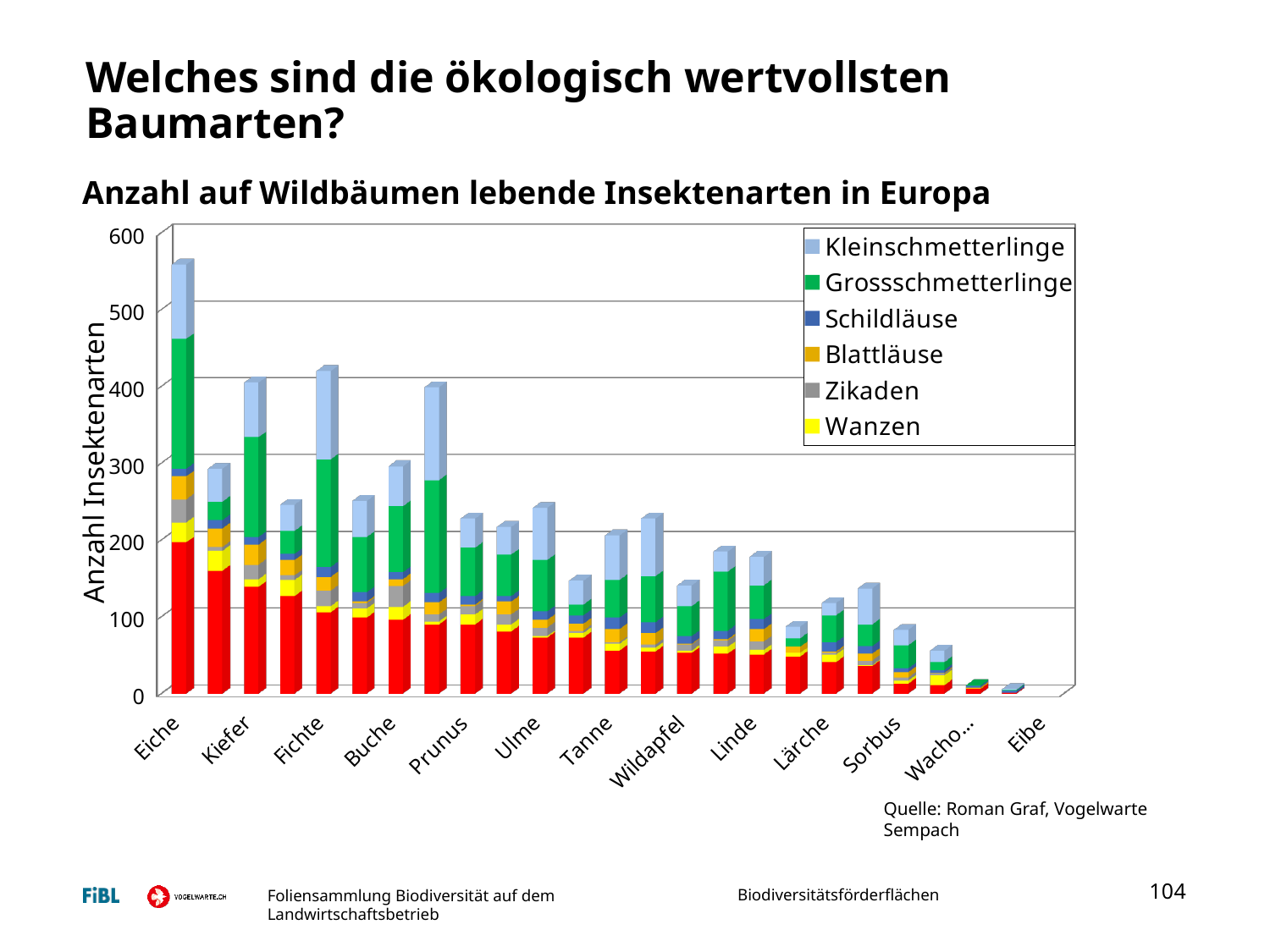
Is the total value for Sorbus greater or less than 100? less Which labelled tree species has the lowest total number of insect species? Eibe Is the total value for Prunus greater or less than 200? greater Which tree species has the highest total number of insect species? Eiche Which has a larger total, Eiche or Kiefer? Eiche Is the total value for Eiche greater or less than 500? greater How many series does the legend list? 6 What kind of chart is shown on the slide? stacked bar chart Which has a larger total, Fichte or Lärche? Fichte Do the bar totals generally rise or fall from left to right along the x axis? fall